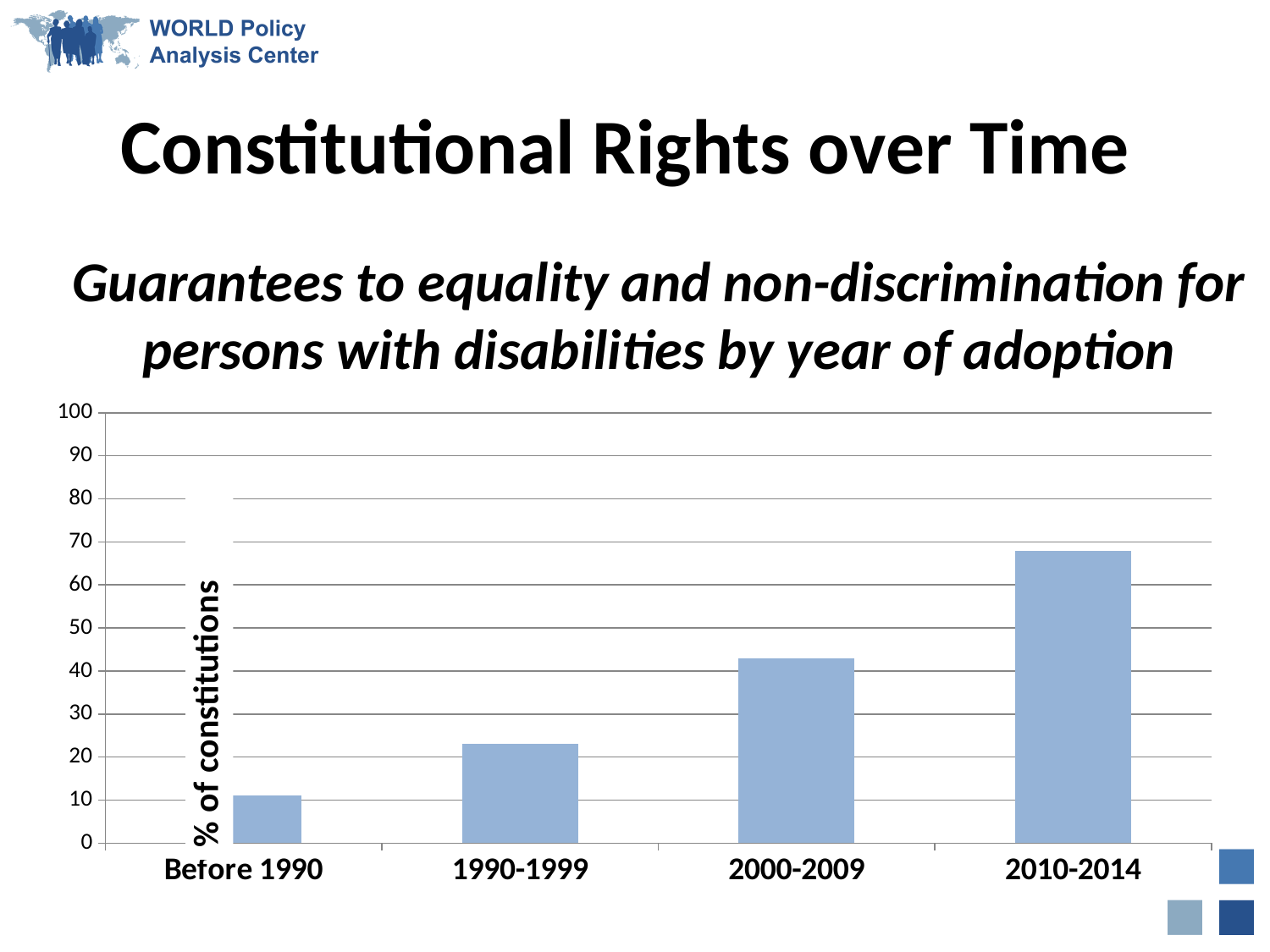
What is the label of the y axis? % of constitutions Is the value for Before 1990 greater or less than 20? less Which time period has the highest percentage of constitutions? 2010-2014 Is the value for 2010-2014 greater or less than 60? greater How many categories (time periods) are shown on the x axis? 4 What kind of chart is shown on the slide? bar chart Is the value for 1990-1999 greater or less than 30? less Which time period has the lowest percentage of constitutions? Before 1990 Which is larger, the value for 1990-1999 or the value for 2000-2009? 2000-2009 What is the maximum value shown on the y axis? 100 Do the values rise or fall from Before 1990 to 2010-2014? rise